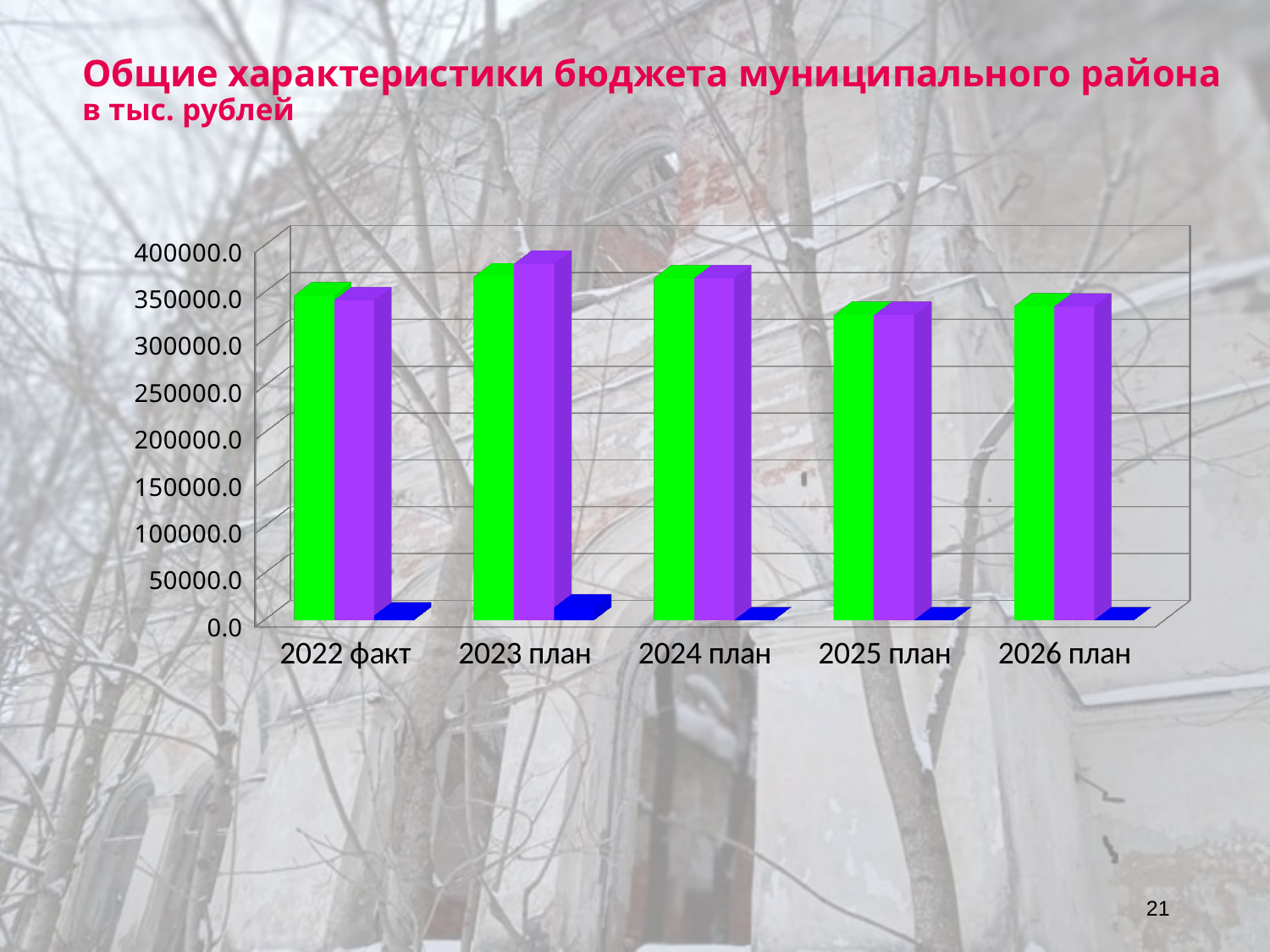
What kind of chart is shown on the slide? bar chart Which category has the tallest purple bar? 2023 план Is the value of the purple bar for 2025 план greater or less than 350000.0? less Is the value of the purple bar for 2023 план greater or less than 350000.0? greater How many categories are shown on the x axis of the chart? 5 What is the title of the chart on the slide? Общие характеристики бюджета муниципального района For 2023 план, which bar is taller, the green one or the purple one? the purple one Is the value of the blue bar for 2023 план greater or less than 50000.0? less Which category has the tallest blue bar? 2023 план In what units are the values on the chart expressed, according to the slide? в тыс. рублей Do the green bars rise or fall from 2023 план to 2025 план? fall